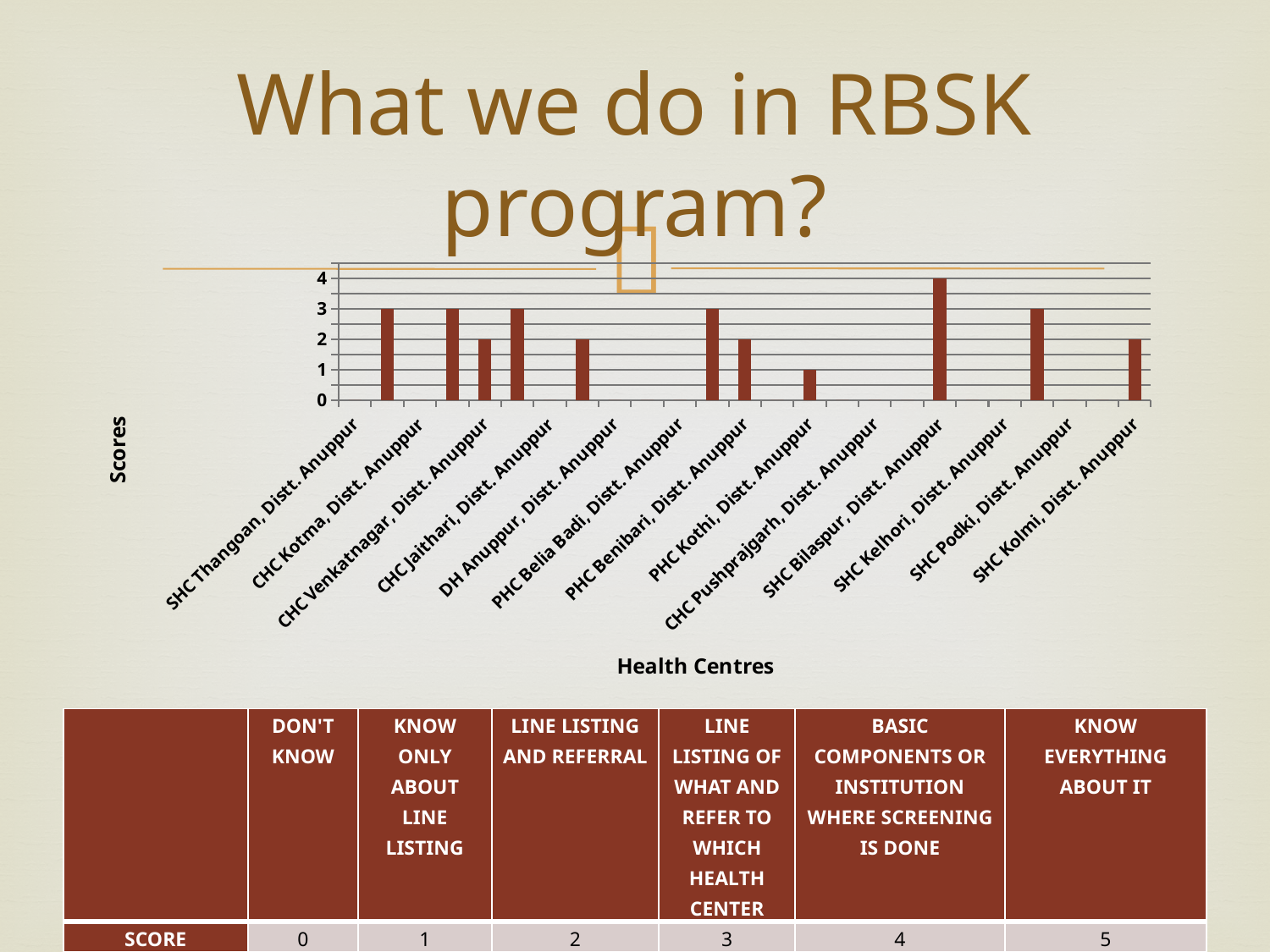
How many bars in the chart reach a score of 4? 1 Is the shortest bar in the chart greater or less than 2? less What is the lowest non-zero score reached by any bar in the chart? 1 What is the title of the x-axis of the chart? Health Centres What is the title of the y-axis of the chart? Scores What is the highest score reached by any bar in the chart? 4 How many health centres are labelled on the x-axis of the chart? 13 Is the tallest bar in the chart greater or less than 3? greater What is the maximum value shown on the y-axis of the chart? 4 What type of chart is shown on the slide? bar chart